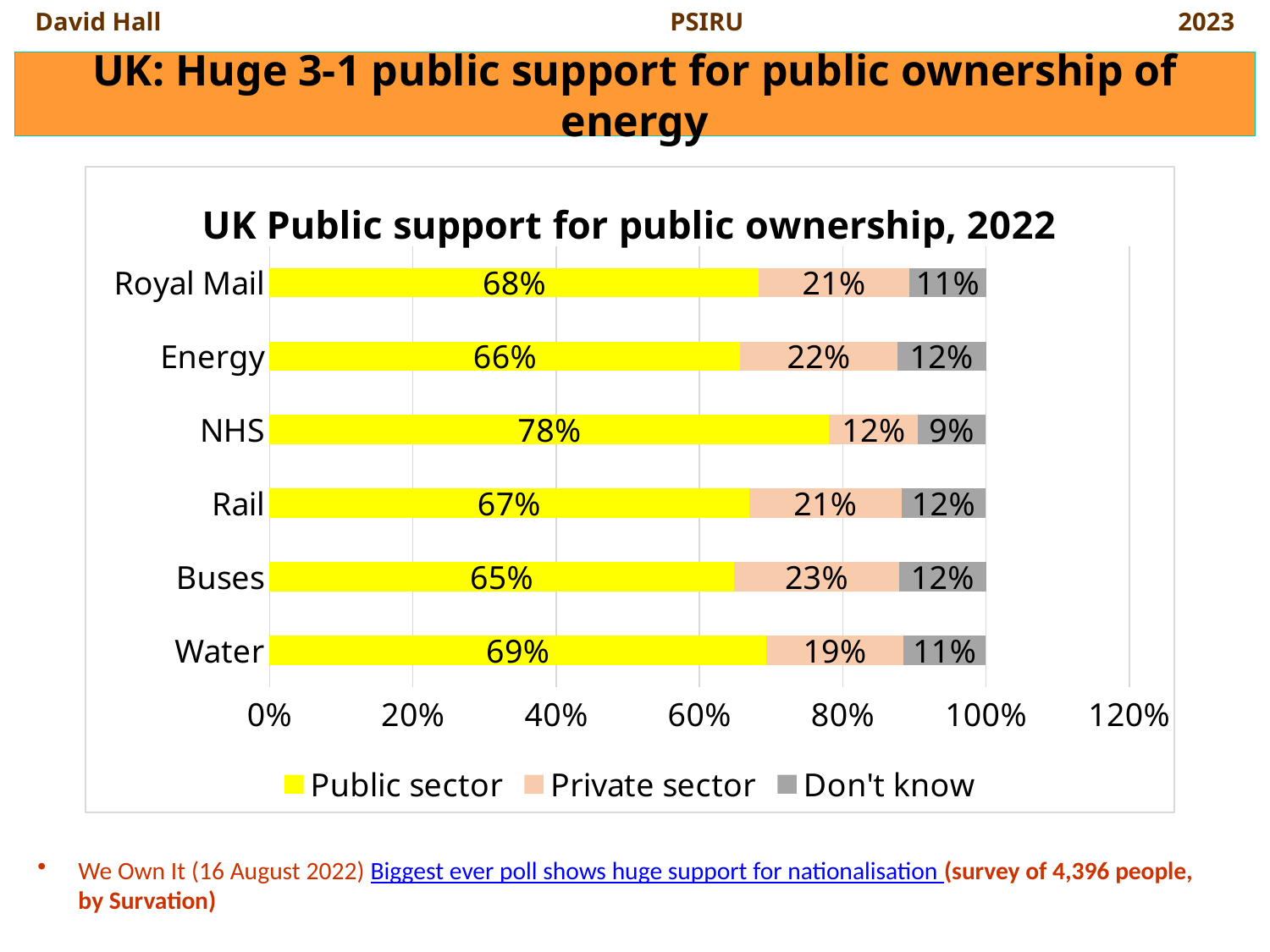
What is the title of the chart? UK Public support for public ownership, 2022 What is the Don't know value for Water? 11% Which has a larger Private sector value, Royal Mail or Water? Royal Mail How many categories are shown on the chart? 6 Is the Public sector value for Rail greater or less than 60%? greater How many series does the legend list? 3 What kind of chart is shown on the slide? Stacked bar chart Which category has the highest Public sector value? NHS Which category has the lowest Public sector value? Buses What is the difference between the Public sector values for NHS and Energy? 12% What percentage of respondents support public sector ownership of the NHS? 78% What is the Private sector value for Buses? 23%